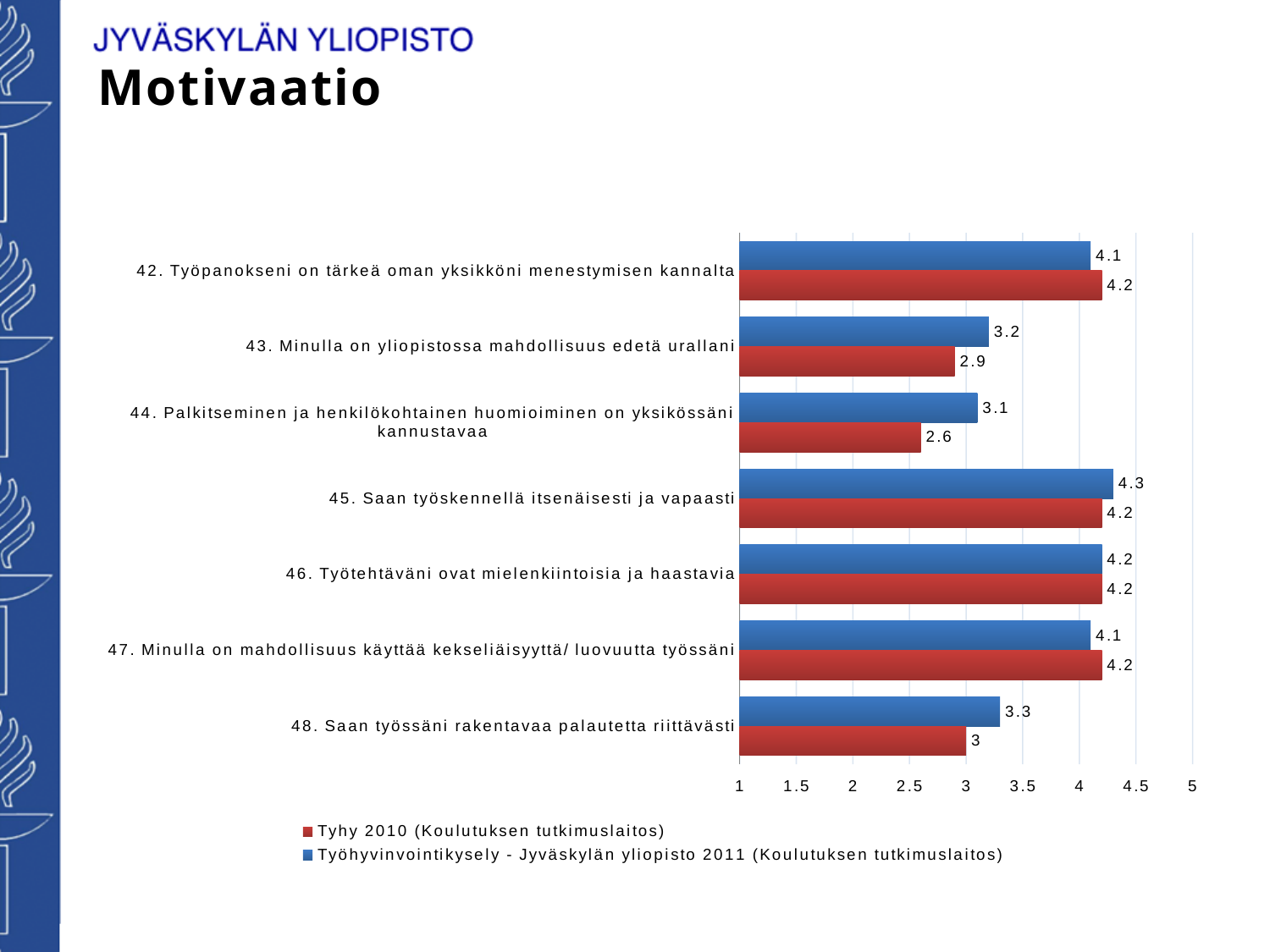
What is the Työhyvinvointikysely 2011 value for statement 45 (Saan työskennellä itsenäisesti ja vapaasti)? 4.3 Which statement has the lowest Tyhy 2010 value? 44. Palkitseminen ja henkilökohtainen huomioiminen on yksikössäni kannustavaa What is the Tyhy 2010 value for statement 44 (Palkitseminen ja henkilökohtainen huomioiminen on yksikössäni kannustavaa)? 2.6 Which statement has the highest Työhyvinvointikysely 2011 value? 45. Saan työskennellä itsenäisesti ja vapaasti How many series does the legend list? 2 Is the Tyhy 2010 value for statement 43 greater or less than 3? less How many categories (statements) are plotted in the chart? 7 What is the difference between the 2011 and 2010 values for statement 44? 0.5 For statement 43 (Minulla on yliopistossa mahdollisuus edetä urallani), which series has the larger value: Tyhy 2010 or Työhyvinvointikysely 2011? Työhyvinvointikysely 2011 What is the Tyhy 2010 value for statement 48 (Saan työssäni rakentavaa palautetta riittävästi)? 3 Which colour represents the Tyhy 2010 series in the chart? Red What kind of chart is shown on the slide? Bar chart